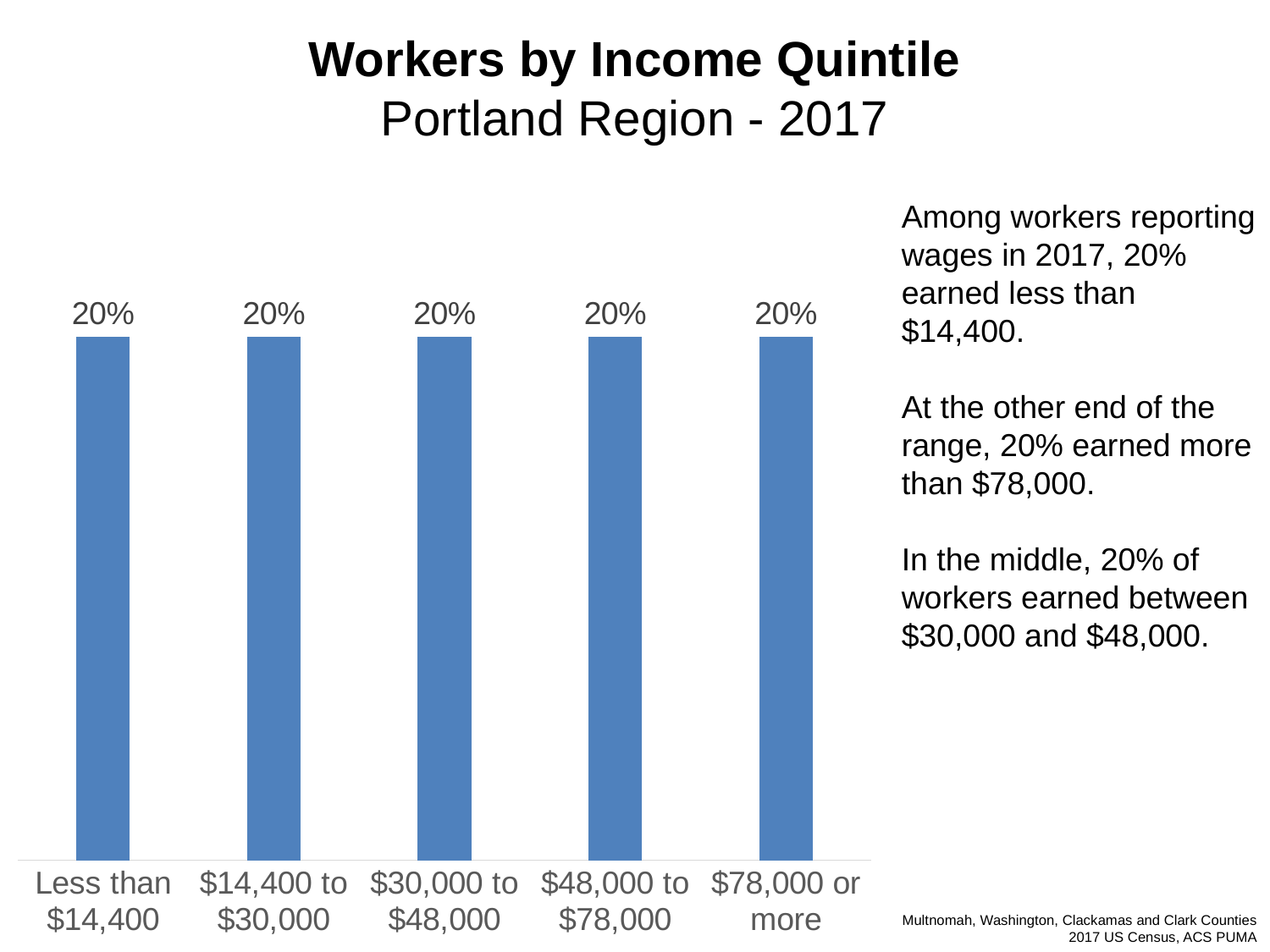
What is the difference between the values for '$14,400 to $30,000' and '$48,000 to $78,000'? 0% What is the title of the chart? Workers by Income Quintile, Portland Region - 2017 What is the label of the leftmost category on the x axis? Less than $14,400 What is the total of all five bars' values? 100% What kind of chart is shown on the slide? Bar chart What is the value for the '$78,000 or more' category? 20% What is the value for the '$30,000 to $48,000' category? 20% Do the values rise, fall, or stay the same across the income categories from left to right? Stay the same What is the value for the 'Less than $14,400' category? 20% How many income categories are shown on the chart? 5